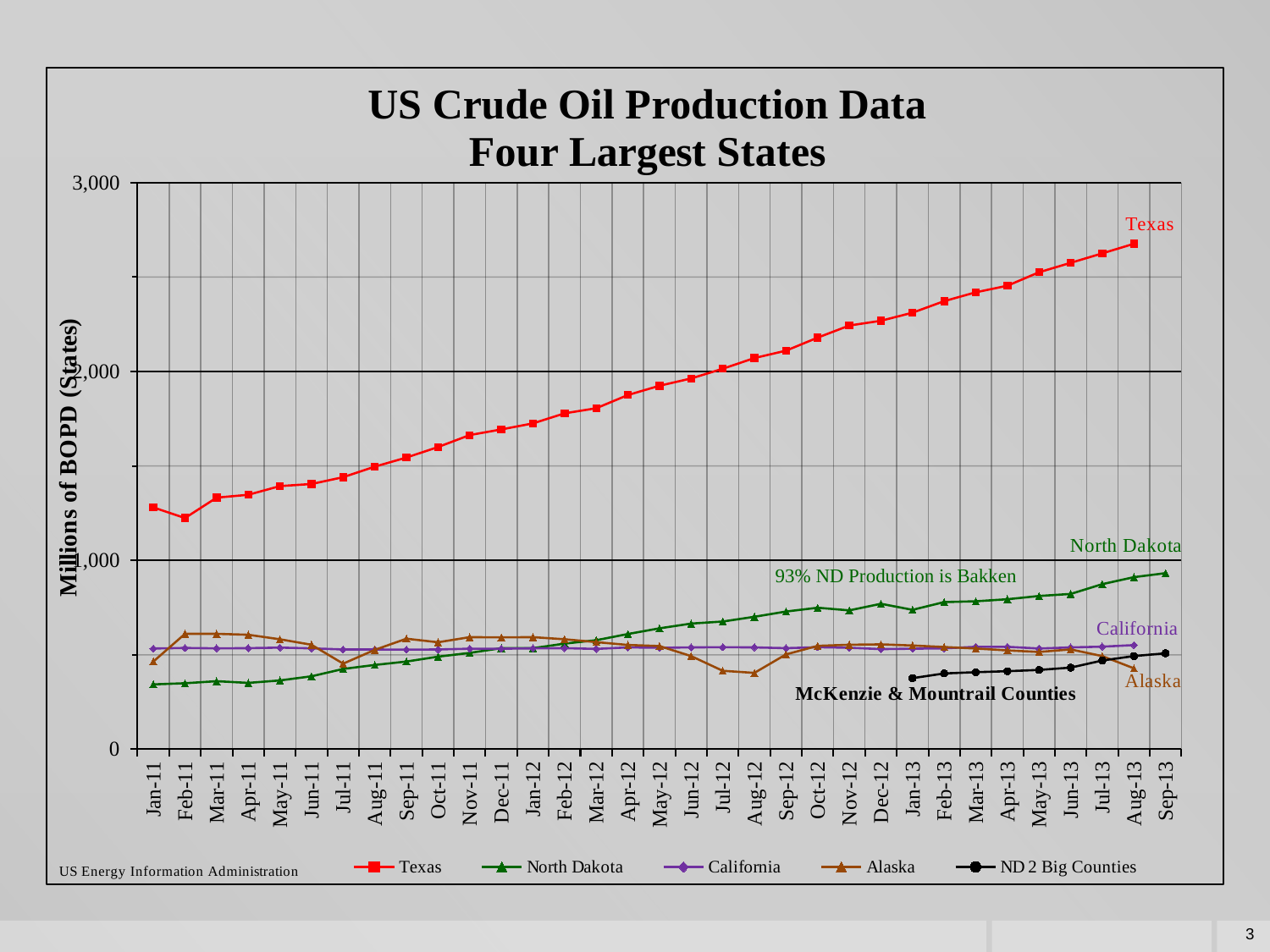
Which state has the highest crude oil production throughout the chart? Texas Which is larger in Aug-13, North Dakota or California? North Dakota How many monthly points are shown along the x axis? 33 Is the value for North Dakota in Sep-13 greater or less than 1,000? less How many series does the legend list? 5 Is the value for Texas in Jan-12 greater or less than 2,000? less Which is larger in Jan-11, North Dakota or Alaska? Alaska Which series has the lowest value in Jan-11? North Dakota Is the value for Texas in Aug-13 greater or less than 2,000? greater What kind of chart is shown on the slide? Line chart What is the title of the chart? US Crude Oil Production Data Four Largest States Does Texas production rise or fall from Jan-11 to Aug-13? Rise